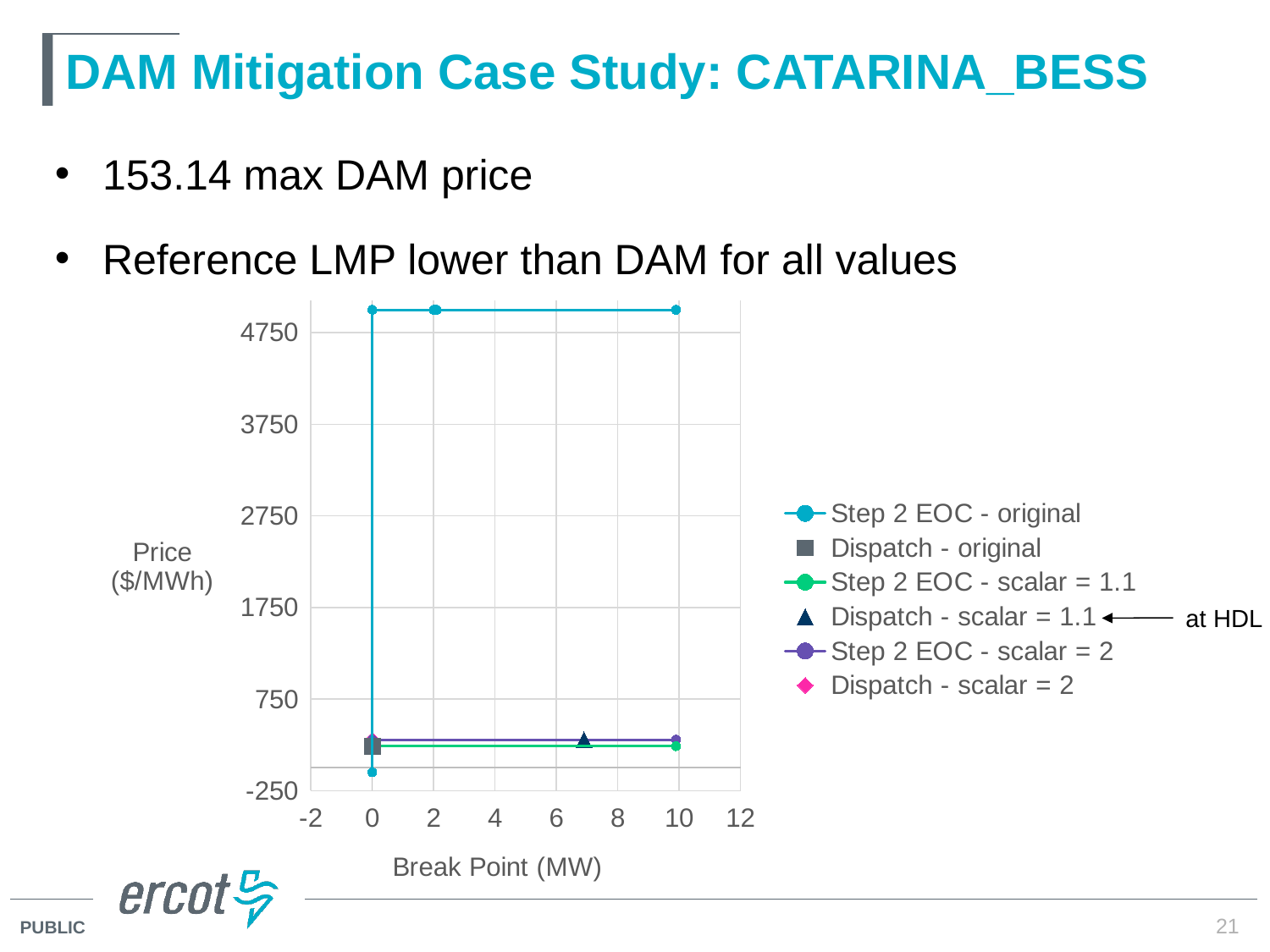
What is the label of the chart's horizontal axis? Break Point (MW) What is the label of the chart's vertical axis? Price ($/MWh) Which legend entry does the 'at HDL' annotation point to? Dispatch - scalar = 1.1 Is the value of the Step 2 EOC - scalar = 2 series at a break point of 10 MW greater or less than 1750? less Is the lowest point of the Step 2 EOC - original series greater or less than 750? less Which series reaches the highest price on the chart? Step 2 EOC - original What kind of chart is shown on the slide? line chart Between break points of 2 MW and 10 MW, does the Step 2 EOC - original series rise, fall, or stay flat? stays flat How many series does the chart legend list? 6 Is the value of the Step 2 EOC - original series at a break point of 10 MW greater or less than 4750? greater At a break point of 10 MW, which is larger: the Step 2 EOC - original value or the Step 2 EOC - scalar = 2 value? Step 2 EOC - original